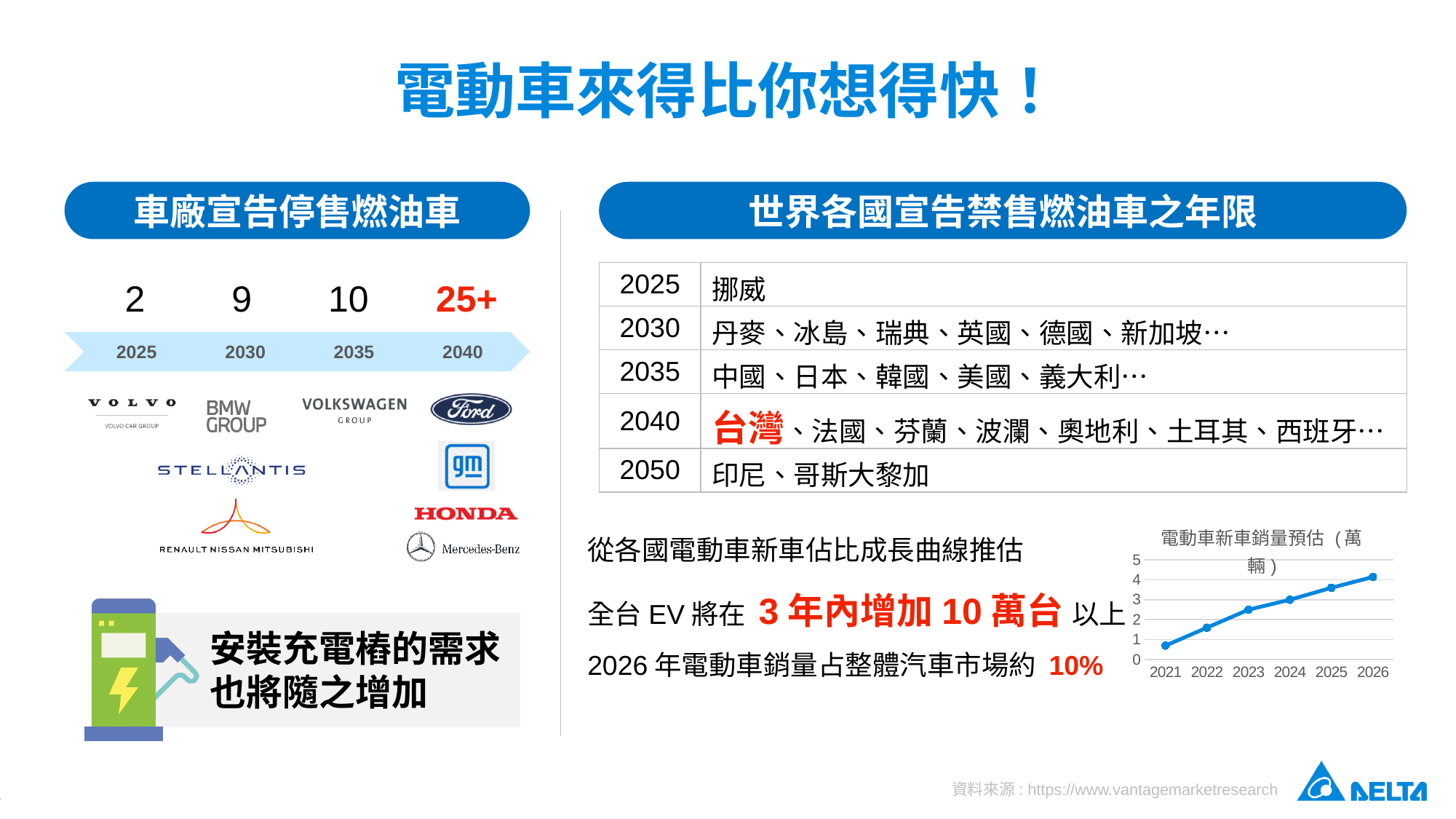
What kind of chart is the chart titled 電動車新車銷量預估（萬輛）? line chart What is the title of the line chart at the bottom right of the slide? 電動車新車銷量預估（萬輛） In the chart 電動車新車銷量預估（萬輛）, which year has the lowest value? 2021 In the chart 電動車新車銷量預估（萬輛）, which year has the highest value? 2026 In the chart 電動車新車銷量預估（萬輛）, do the values rise or fall from 2021 to 2026? rise In the chart 電動車新車銷量預估（萬輛）, what is the highest value shown on the y axis? 5 In the chart 電動車新車銷量預估（萬輛）, is the value for 2024 greater or less than 2? greater In the chart 電動車新車銷量預估（萬輛）, is the value for 2021 greater or less than 2? less In the chart 電動車新車銷量預估（萬輛）, how many years are plotted on the x axis? 6 In the chart 電動車新車銷量預估（萬輛）, which year has the larger value, 2022 or 2025? 2025 In the chart 電動車新車銷量預估（萬輛）, is the value for 2025 greater or less than 5? less